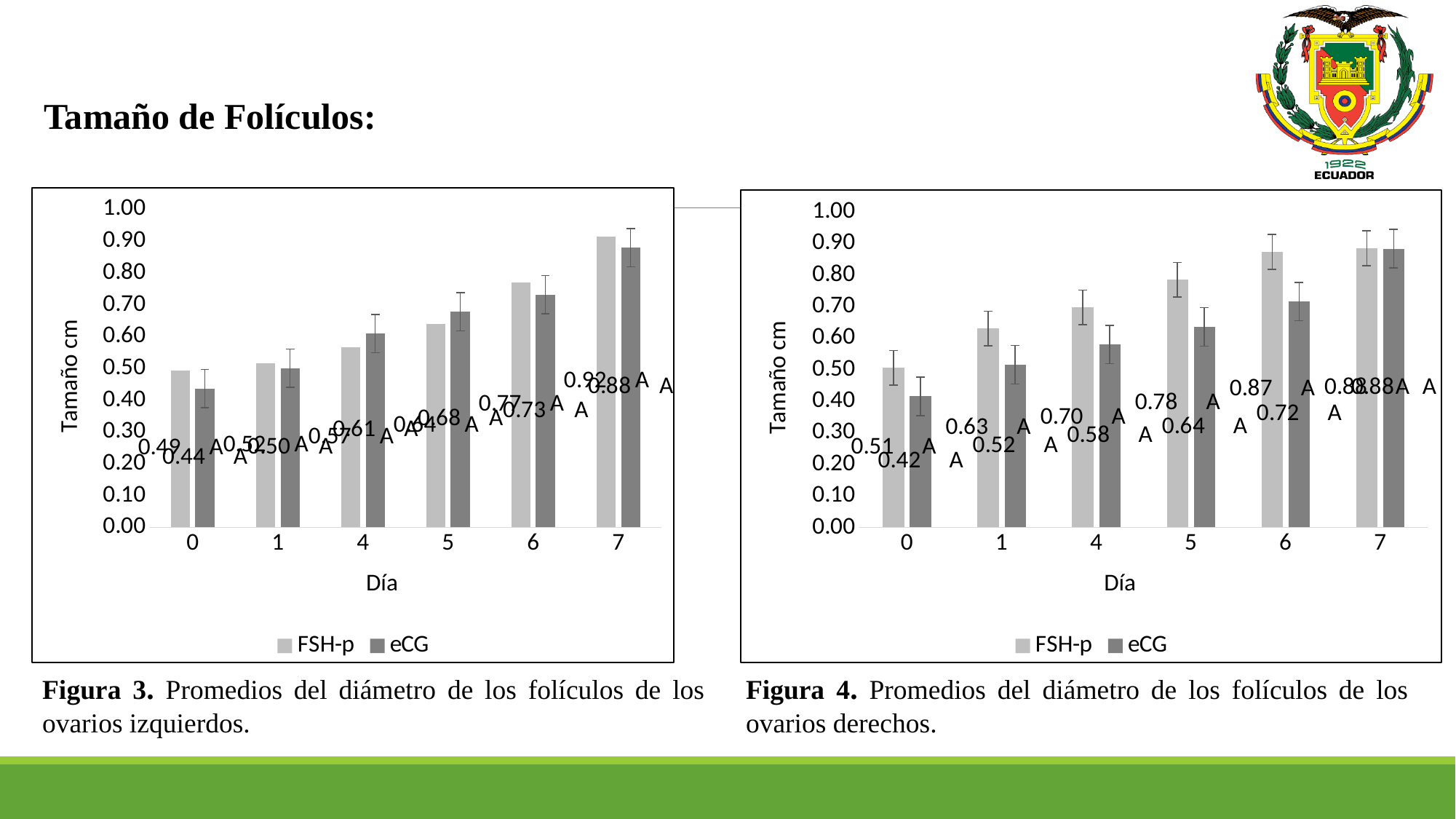
In the left chart (Figura 3), what is the difference between the FSH-p and eCG values on day 7? 0.04 In the right chart (Figura 4), what is the eCG value on day 0? 0.42 In the right chart (Figura 4), what is the FSH-p value on day 6? 0.87 In the right chart (Figura 4), on which day is the eCG value lowest? 0 In the left chart (Figura 3), on which day is the FSH-p value highest? 7 In the left chart (Figura 3), do the FSH-p values rise or fall from day 0 to day 7? rise In the right chart (Figura 4), which is larger on day 5, FSH-p or eCG? FSH-p In the left chart (Figura 3), what is the eCG value on day 6? 0.73 In the right chart (Figura 4), what is the difference between the FSH-p and eCG values on day 1? 0.11 How many series does the legend of the right chart (Figura 4) list? 2 In the left chart (Figura 3), what is the FSH-p value on day 7? 0.92 In the left chart (Figura 3), what is the eCG value on day 0? 0.44